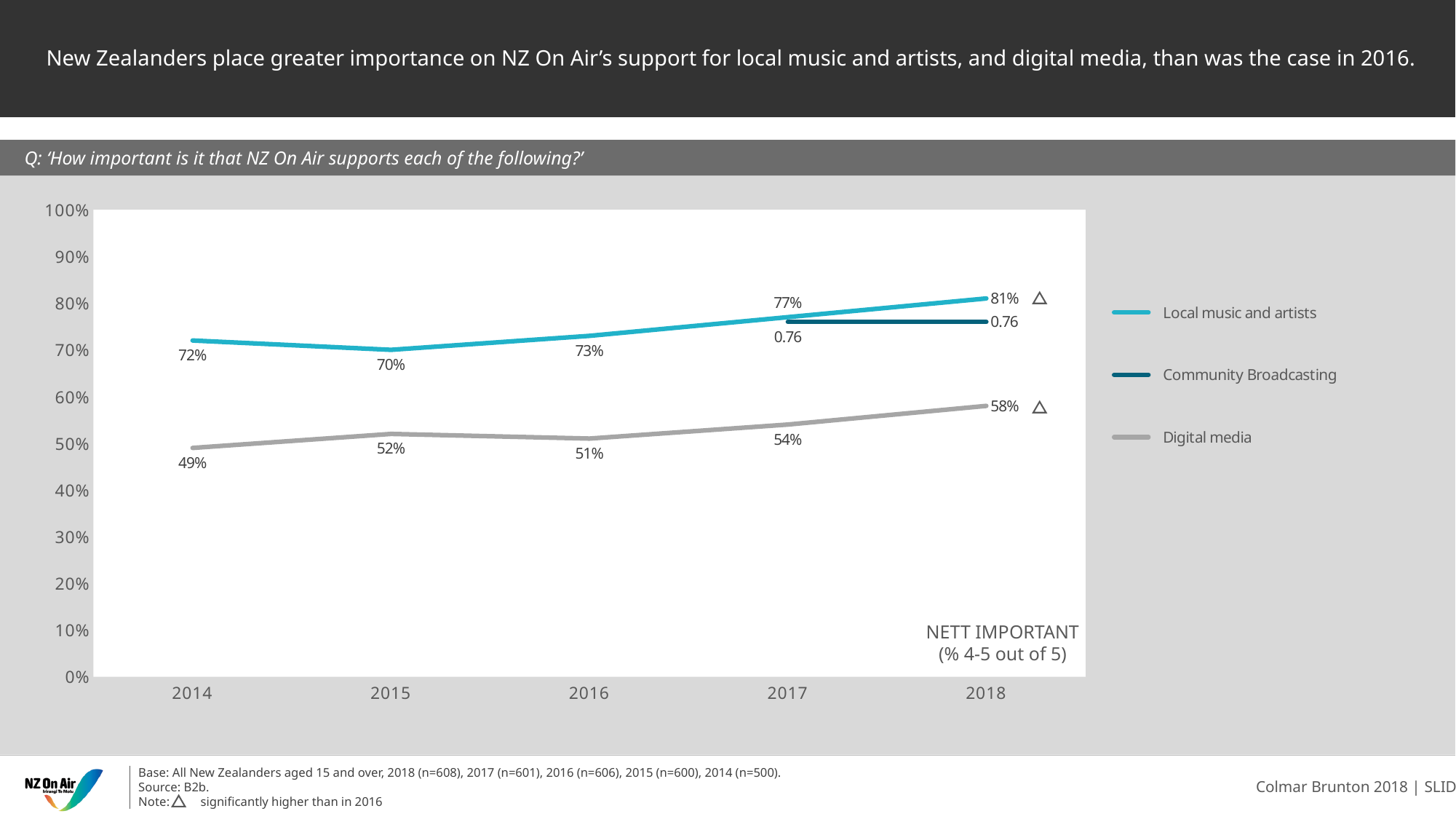
In which year is the Digital media value lowest? 2014 What is the value for Local music and artists in 2015? 70% What is the value for Digital media in 2017? 54% In which year is the Local music and artists value highest? 2018 What is the value for Local music and artists in 2018? 81% Does the Digital media line rise or fall from 2016 to 2018? Rise What is the value for Digital media in 2014? 49% What kind of chart is shown on the slide? Line chart What is the difference between Local music and artists and Digital media in 2018? 23% Which is larger in 2016: Local music and artists or Digital media? Local music and artists How many series does the legend list? 3 How many years are shown on the x axis? 5